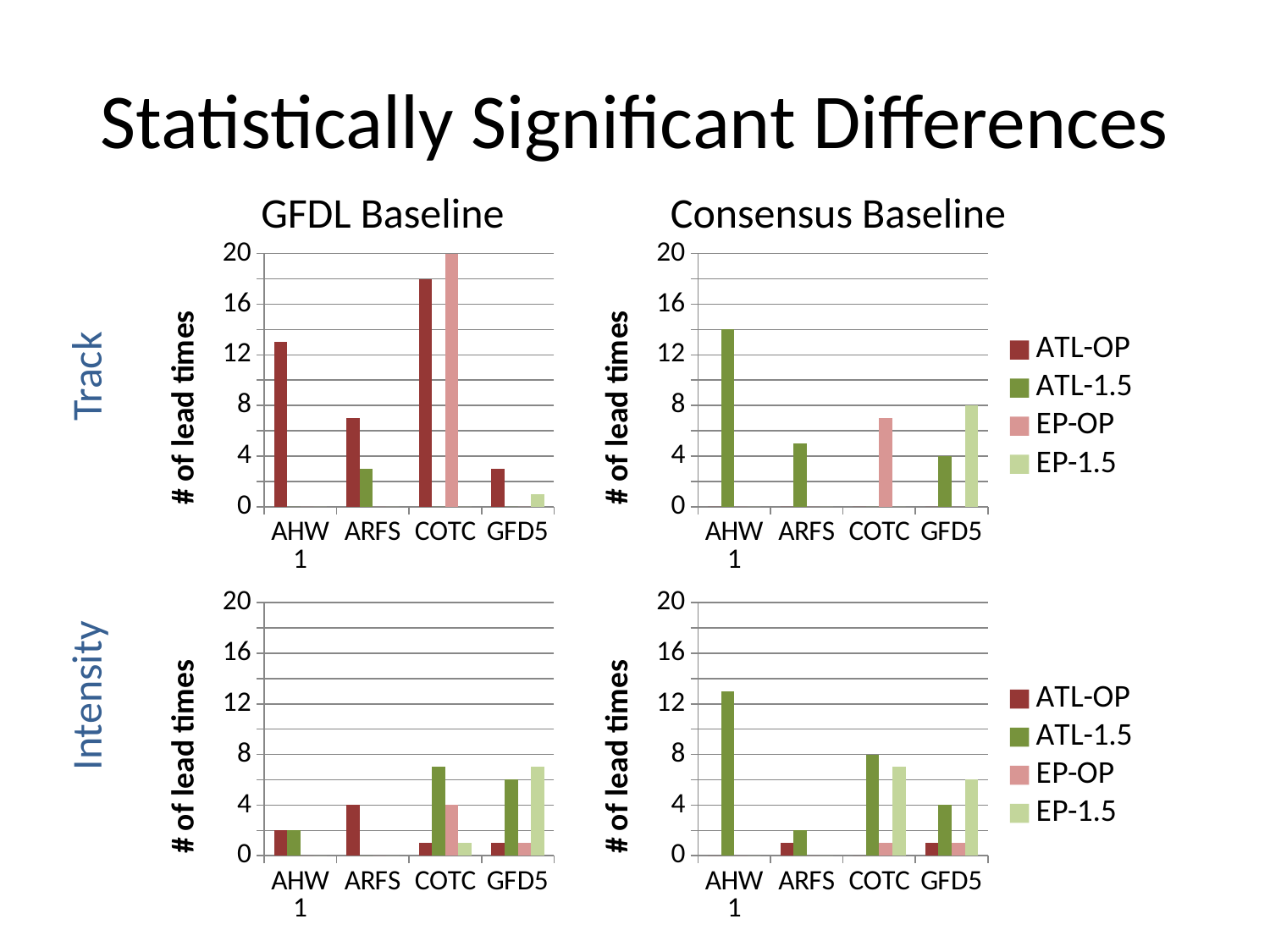
How many series does the legend list for the Track charts (top row)? 4 What is the y-axis label on the Intensity / GFDL Baseline chart (bottom-left)? # of lead times In the Track / Consensus Baseline chart (top-right), what is the value of EP-1.5 for GFD5? 8 In the Track / GFDL Baseline chart (top-left), which is larger: ATL-OP for AHW1 or ATL-OP for ARFS? ATL-OP for AHW1 In the Track / Consensus Baseline chart (top-right), which category has the tallest bar? AHW1 In the Intensity / Consensus Baseline chart (bottom-right), what is the value of ATL-1.5 for COTC? 8 How many categories are shown on the x axis of the Intensity / Consensus Baseline chart (bottom-right)? 4 In the Track / GFDL Baseline chart (top-left), what is the value of EP-OP for COTC? 20 In the Track / Consensus Baseline chart (top-right), is the value of ATL-1.5 for AHW1 greater or less than 12? greater What kind of chart is the Track / GFDL Baseline chart (top-left)? bar chart In the Track / GFDL Baseline chart (top-left), is the value of ATL-OP for COTC greater or less than 16? greater In the Intensity / GFDL Baseline chart (bottom-left), what is the value of ATL-OP for ARFS? 4